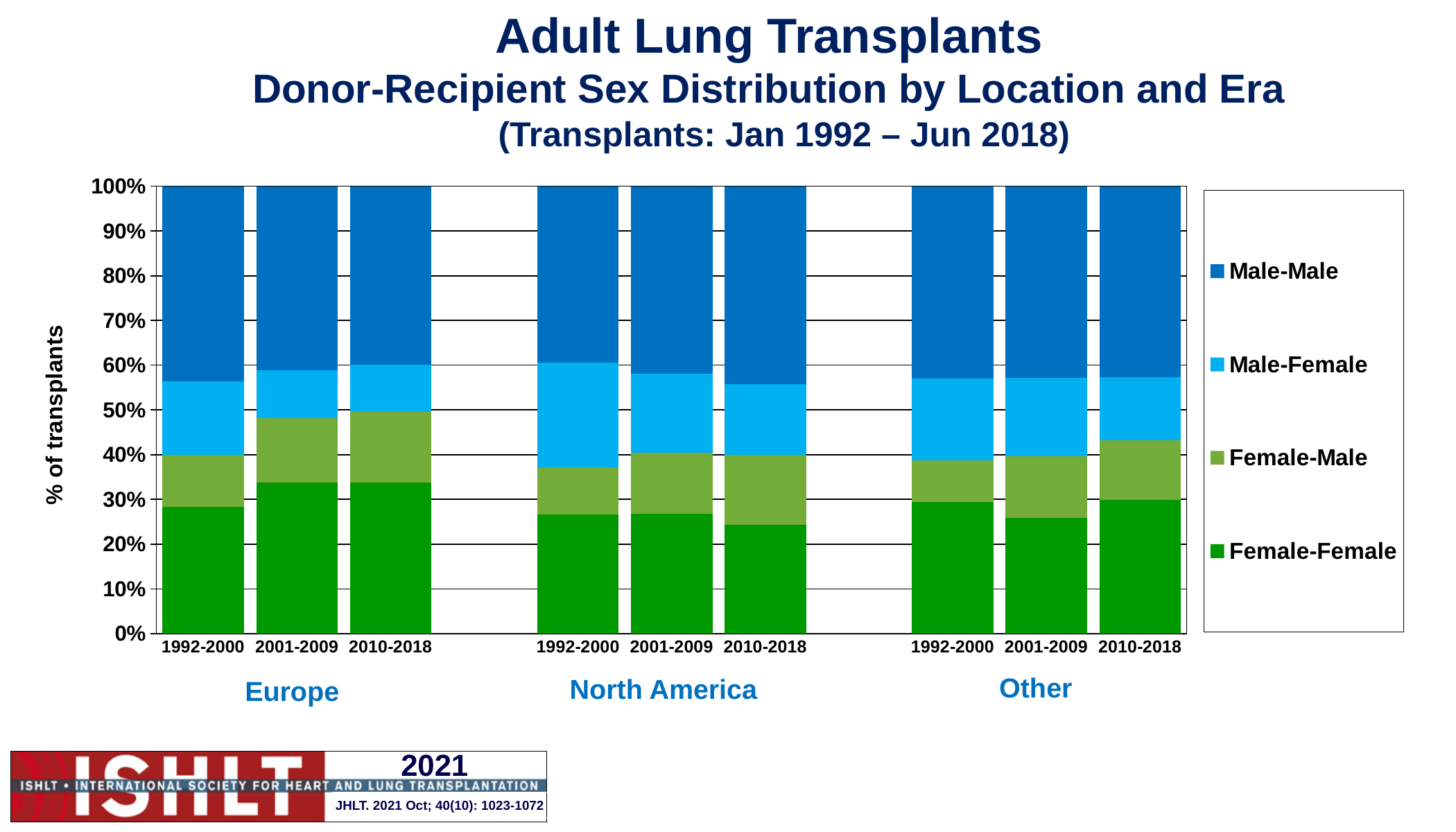
Does the Female-Male share in Europe rise or fall across the three eras? rise Within North America, which era has the lowest Female-Female share? 2010-2018 Which has the larger Female-Female share: Europe 2001-2009 or North America 2010-2018? Europe 2001-2009 How many series does the legend list? 4 How many regions are shown along the x axis? 3 Is the Male-Male share for Other in 1992-2000 greater or less than 40%? greater Is the Female-Female share for Europe in 2001-2009 greater or less than 30%? greater Which has the larger Male-Female share in 1992-2000: Europe or North America? North America What kind of chart is shown on the slide? Stacked bar chart How many bars are plotted in the chart? 9 Is the Female-Female share for North America in 2010-2018 greater or less than 30%? less What is the label on the y axis? % of transplants